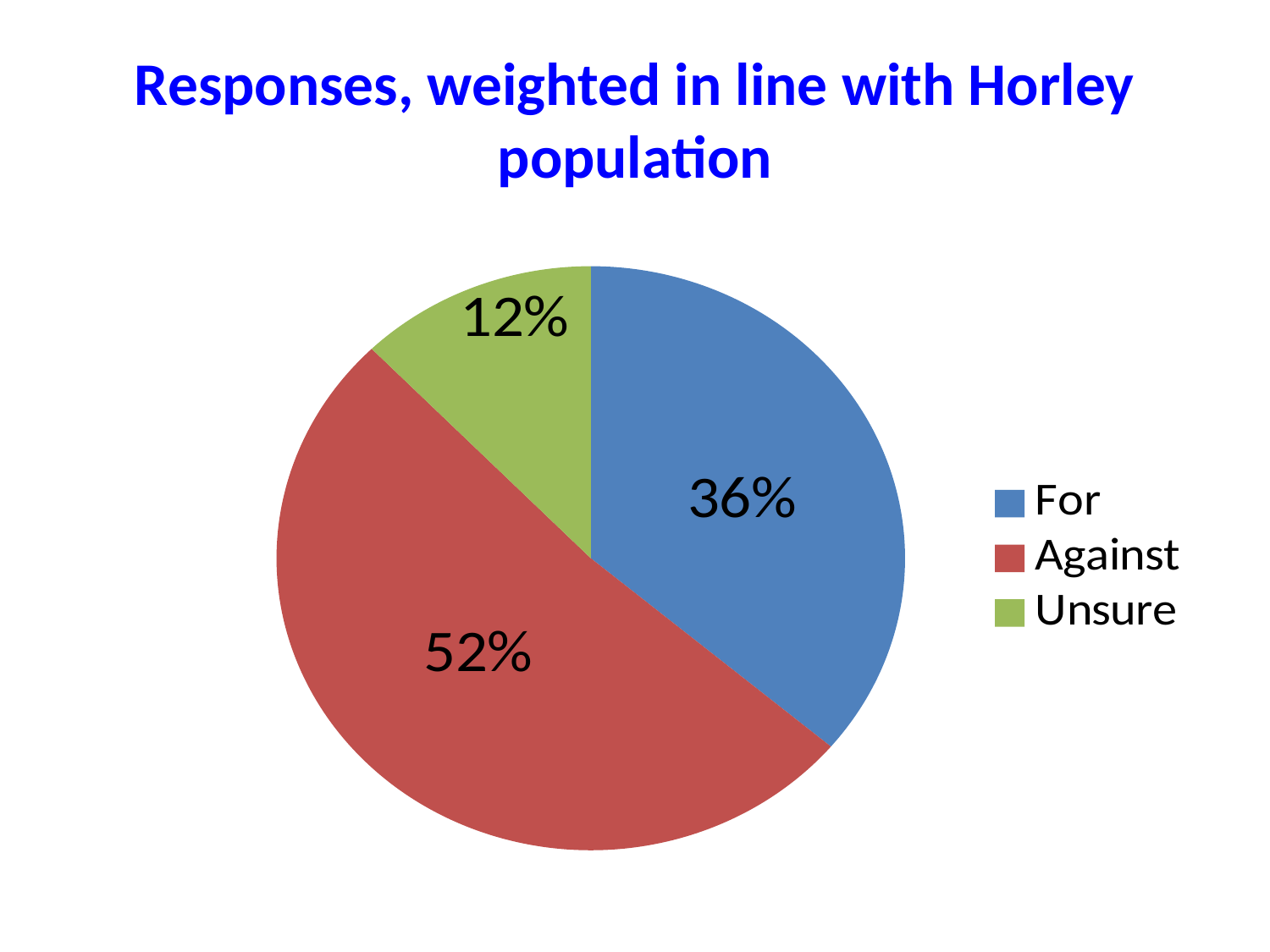
What is the title of the chart? Responses, weighted in line with Horley population What percentage of responses are 'Against'? 52% Which is larger, the share for 'For' or the share for 'Unsure'? For Which response category has the largest share of the pie? Against Which response category has the smallest share of the pie? Unsure What is the difference in percentage points between 'Against' and 'For'? 16 What colour is the 'Against' slice? red How many categories does the pie chart have? 3 What percentage of responses are 'For'? 36% What percentage of responses are 'Unsure'? 12% What is the difference in percentage points between 'For' and 'Unsure'? 24 What kind of chart is shown on the slide? pie chart